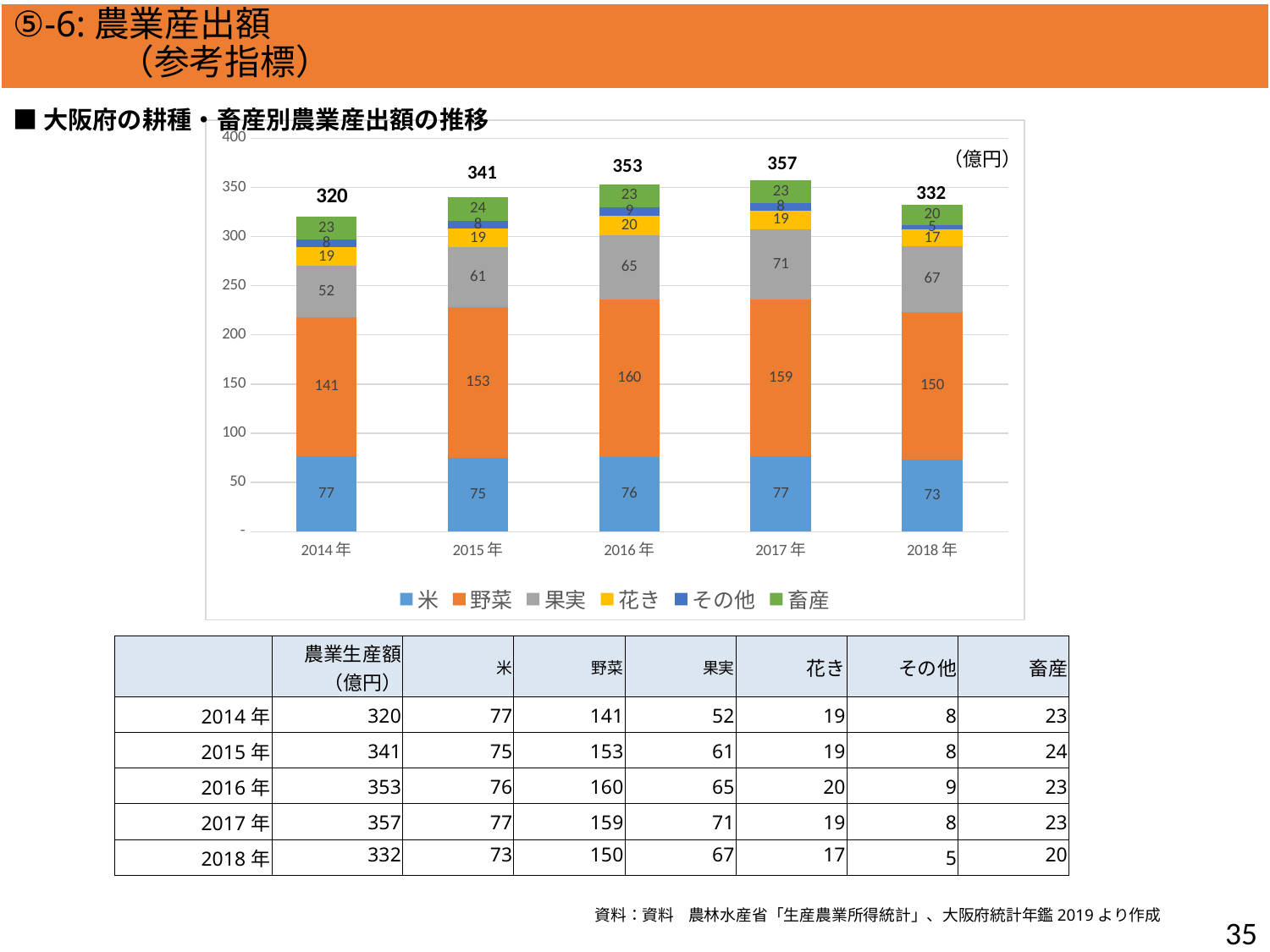
What is the total of the stacked bar for 2017年? 357 How many years are shown on the x axis? 5 What kind of chart is shown? Stacked bar chart How many series does the legend list? 6 Which year has the highest total agricultural output? 2017年 What is the value for 米 in 2018年? 73 What unit is shown in the top right of the chart? 億円 Which year has the lowest total agricultural output? 2014年 Which is larger, the value for 野菜 in 2015年 or in 2018年? 2015年 What is the difference between the total for 2017年 and the total for 2018年? 25 What is the value for 野菜 in 2016年? 160 What is the value for 果実 in 2017年? 71